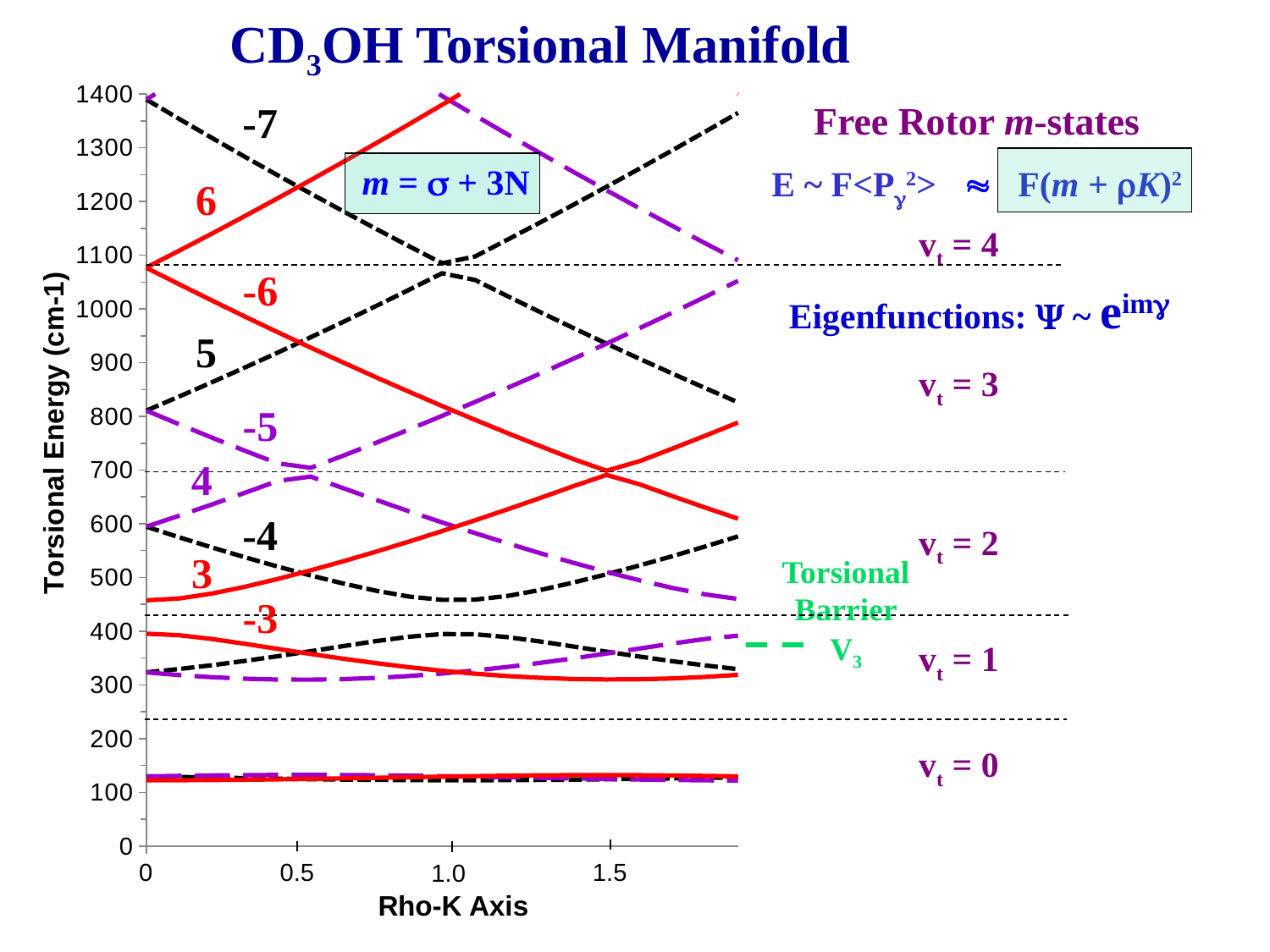
How many v_t levels (v_t = 0, 1, 2, ...) are labeled on the right side of the chart? 5 What kind of chart is shown on the slide? line chart Does the curve labeled 6 rise or fall as Rho-K increases from 0 to 1.0? rise At Rho-K = 0, which curve has the higher torsional energy, the one labeled 6 or the one labeled 5? 6 At Rho-K = 0, is the value of the curve labeled 6 greater or less than 1000? greater What is the title of the chart? CD3OH Torsional Manifold At Rho-K = 0, is the value of the curve labeled 3 greater or less than 500? less What is the highest tick value shown on the y axis? 1400 How many labeled tick marks are there on the x axis? 4 At Rho-K = 0, is the value of the curve labeled -7 greater or less than 1300? greater Does the curve labeled -6 rise or fall as Rho-K increases? fall What is the label of the x axis? Rho-K Axis